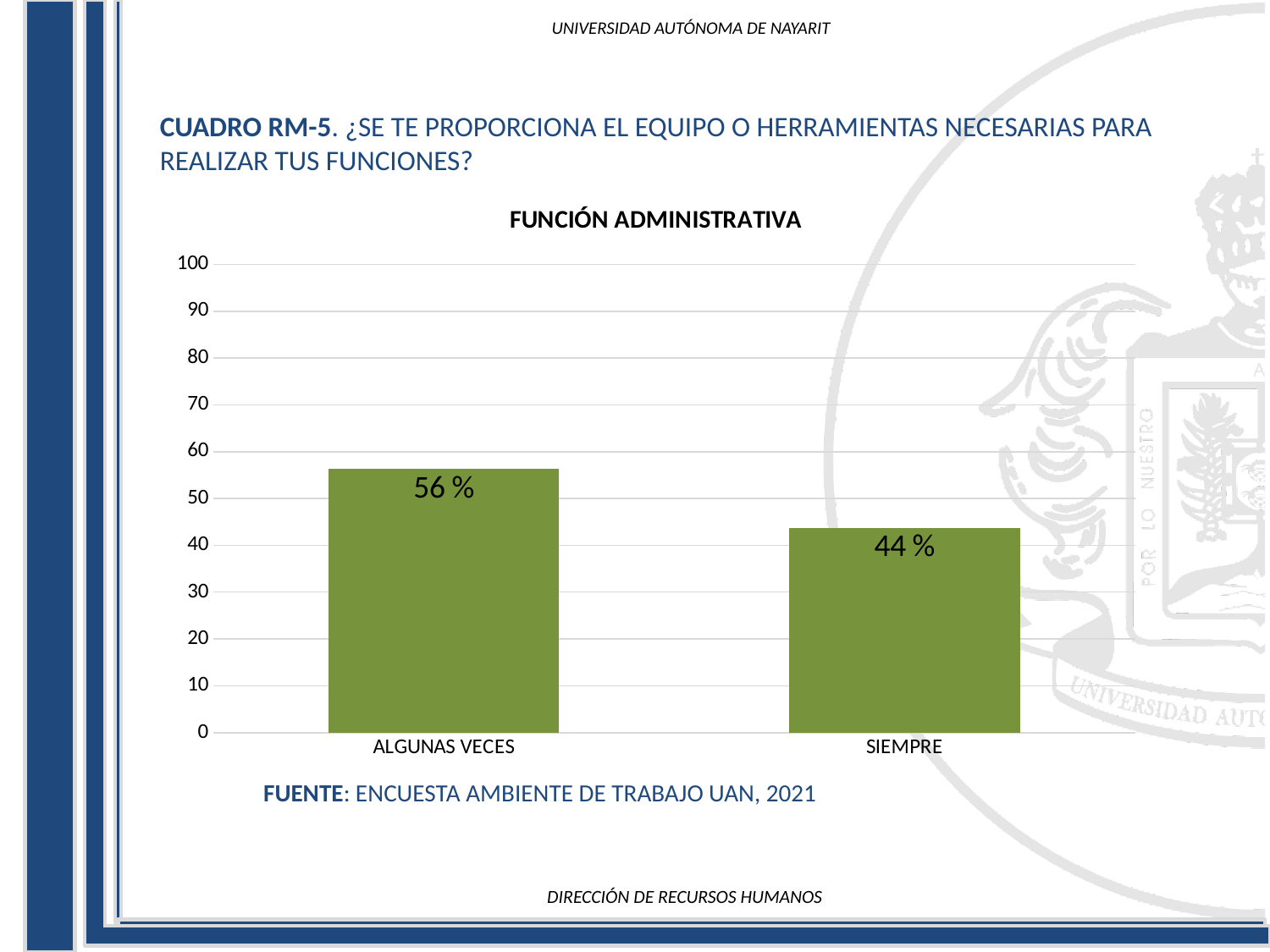
What kind of chart is shown on the slide? bar chart Is the value for ALGUNAS VECES greater or less than 50? greater Is the value for SIEMPRE greater or less than 50? less What is the highest value shown on the y axis? 100 What is the value for SIEMPRE? 44 % Which is larger, the value for ALGUNAS VECES or the value for SIEMPRE? ALGUNAS VECES How many categories are shown on the x axis? 2 What is the value for ALGUNAS VECES? 56 % Which category has the highest value? ALGUNAS VECES Which category has the lowest value? SIEMPRE What is the difference between the values for ALGUNAS VECES and SIEMPRE? 12 % What is the title of the chart? FUNCIÓN ADMINISTRATIVA